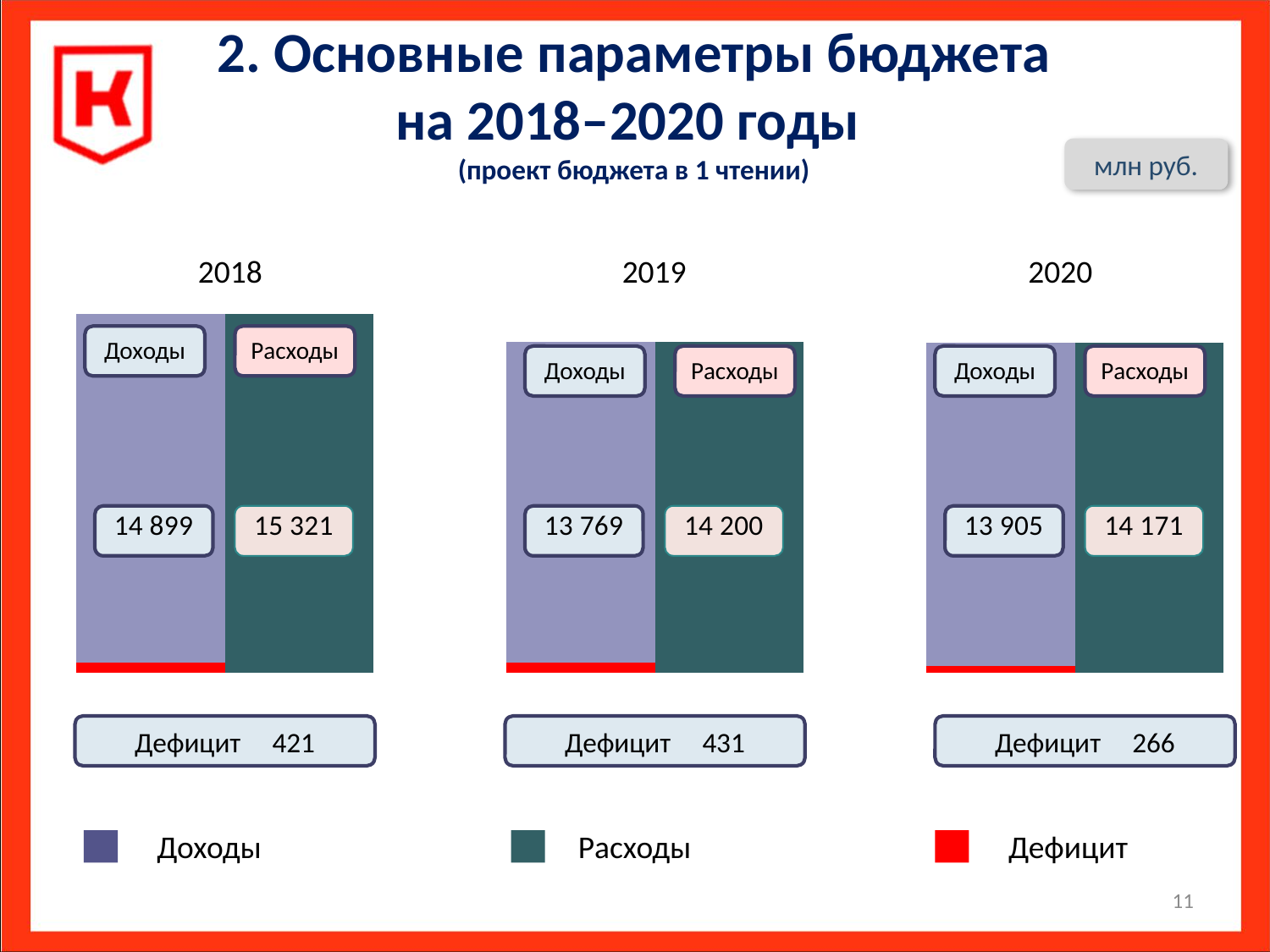
In which year are Доходы the lowest? 2019 What is the Дефицит shown for 2020? 266 Which is larger: Доходы in 2020 or Доходы in 2019? Доходы in 2020 What is the difference between the Дефицит in 2019 and the Дефицит in 2020? 165 How many entries does the legend list? 3 How many years are shown on the chart? 3 What is the value of Доходы for 2018? 14 899 What is the value of Расходы for 2019? 14 200 In which year are Расходы the highest? 2018 What is the difference between Доходы in 2018 and Доходы in 2019? 1 130 In which year is the Дефицит the largest? 2019 Do Расходы rise or fall from 2018 to 2020? fall